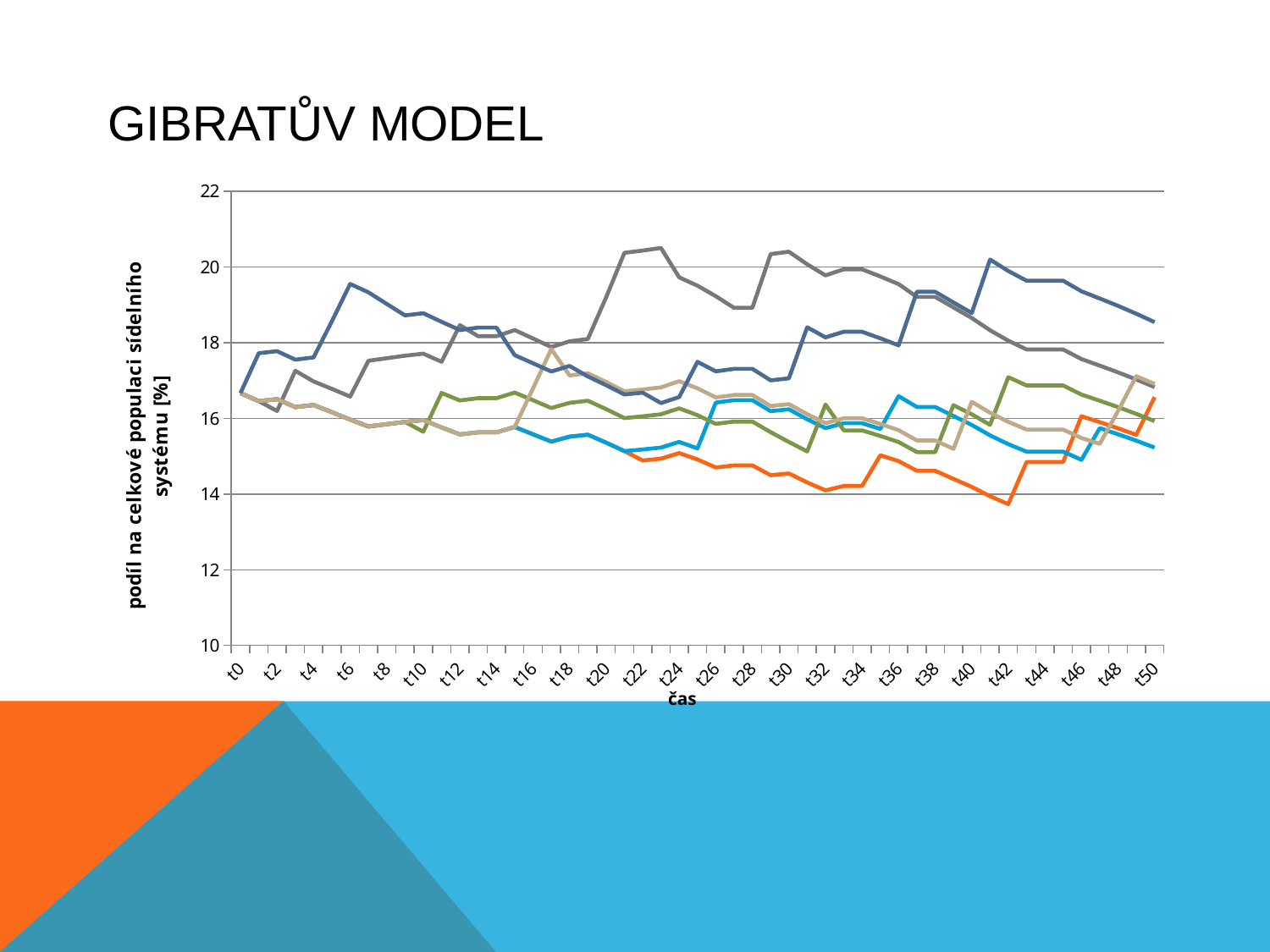
What is the label of the x axis? čas Is the value of the gray line at t24 greater or less than 20? less How many lines are plotted on the chart? 6 Does the dark blue line end higher or lower at t50 than it starts at t0? higher Which line has the highest value at t24? the gray line Is the value of the light blue line at t50 greater or less than 16? less What is the title of the slide containing the chart? GIBRATŮV MODEL What is the highest value shown on the y axis? 22 Is the value of the dark blue line at t6 greater or less than 18? greater Which line has the lowest value at t42? the orange line What kind of chart is shown on the slide? line chart